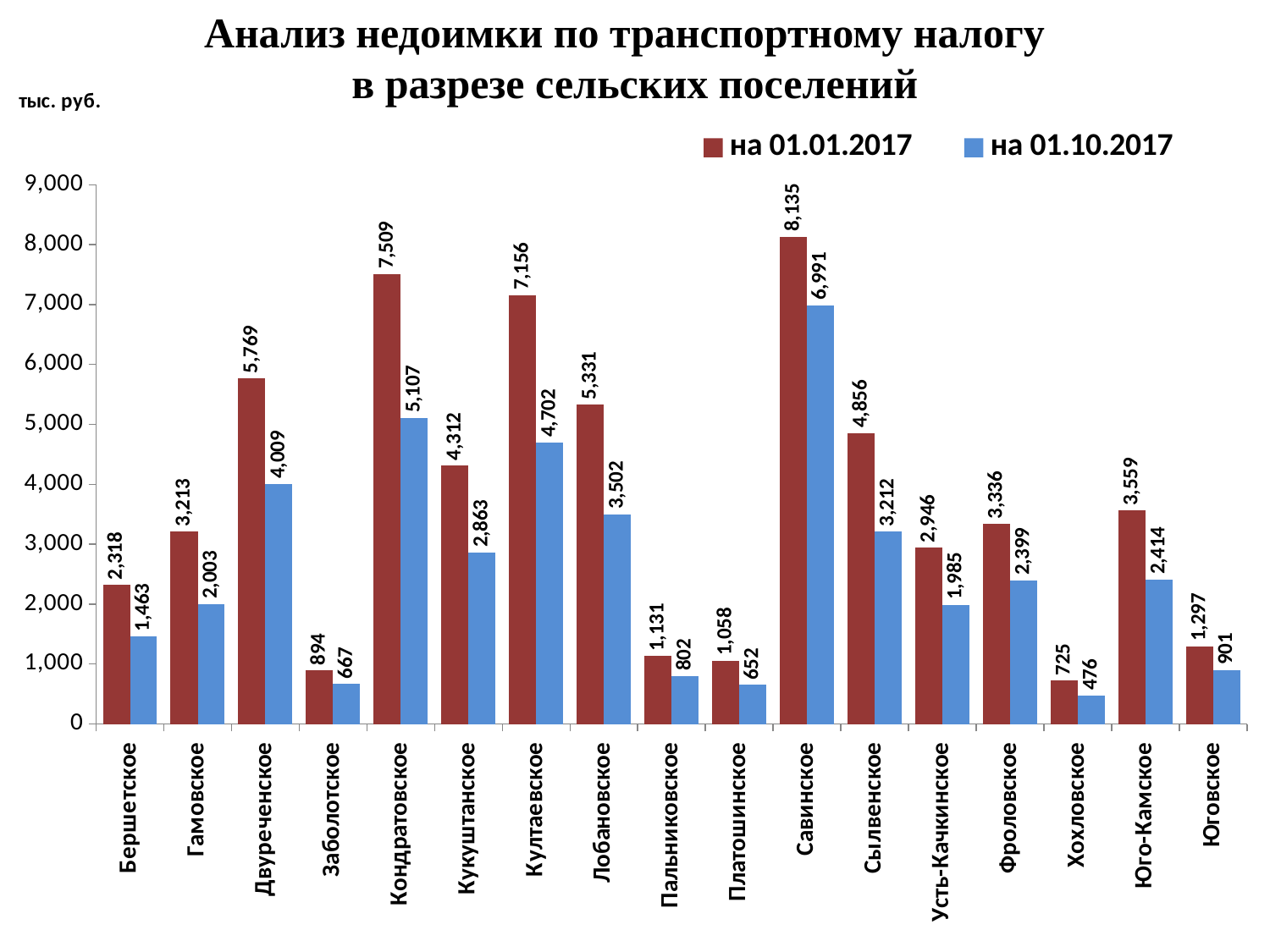
Which is larger in the series на 01.01.2017: Двуреченское or Лобановское? Двуреченское What is the difference between the на 01.01.2017 and на 01.10.2017 values for Савинское? 1,144 How many settlements are shown on the x axis? 17 How many series does the legend list? 2 What is the difference between the на 01.01.2017 and на 01.10.2017 values for Кондратовское? 2,402 What unit is indicated for the values on the chart? тыс. руб. What is the value for Кондратовское in the series на 01.01.2017? 7,509 What is the value for Хохловское in the series на 01.01.2017? 725 Which settlement has the highest value in the series на 01.01.2017? Савинское What kind of chart is shown on the slide? Bar chart Which settlement has the lowest value in the series на 01.10.2017? Хохловское What is the value for Сылвенское in the series на 01.10.2017? 3,212